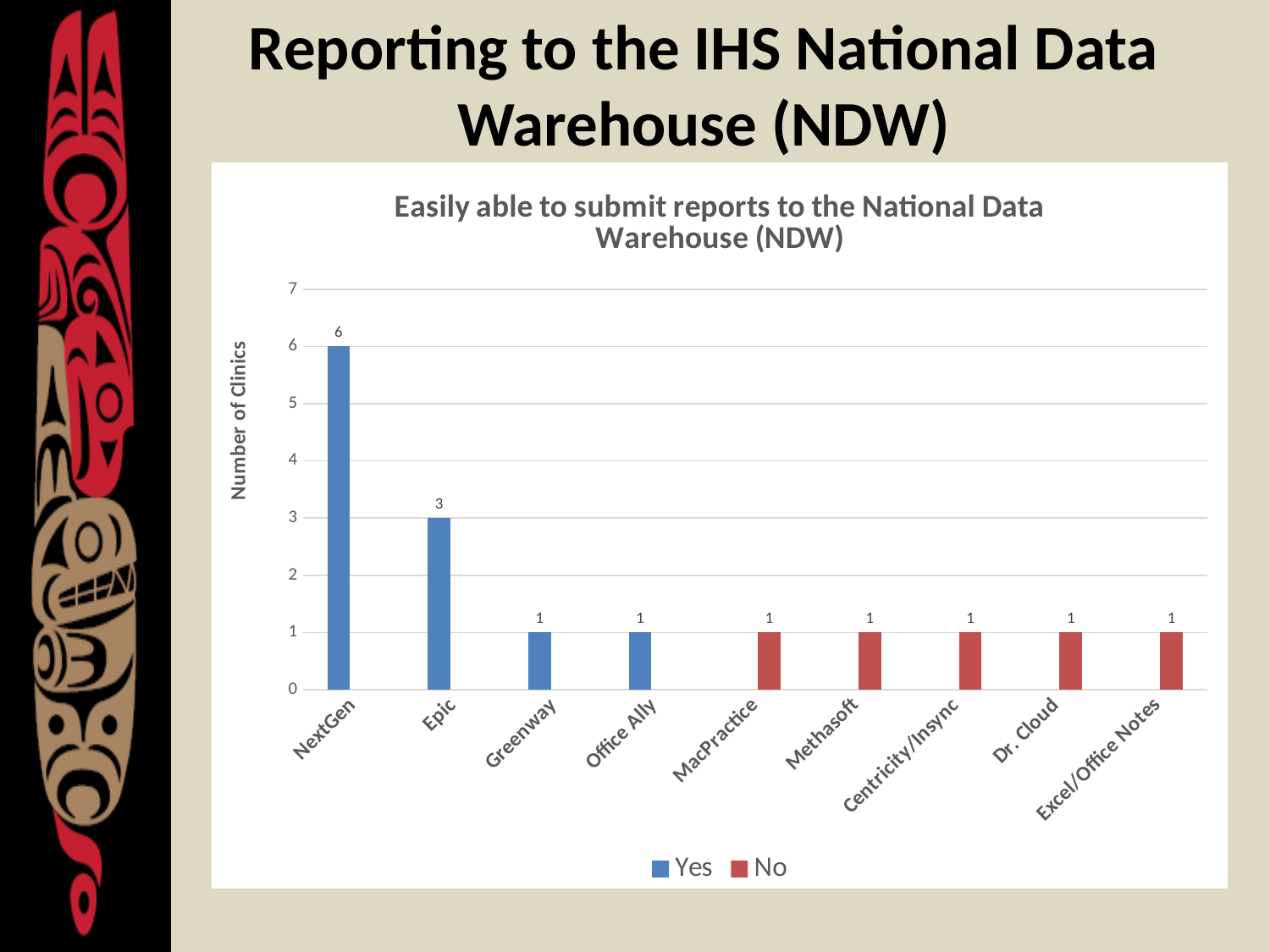
Which category has the highest value? NextGen What is the difference between the values for NextGen and Epic? 3 What is the value for NextGen? 6 What is the label of the y axis? Number of Clinics What is the value for Dr. Cloud? 1 What is the value for Epic? 3 How many series does the legend list? 2 Which series is shown in red? No What kind of chart is shown? bar chart Is the value for NextGen greater or less than 5? greater How many categories are shown on the x axis? 9 Which is larger, the value for Epic or the value for Greenway? Epic